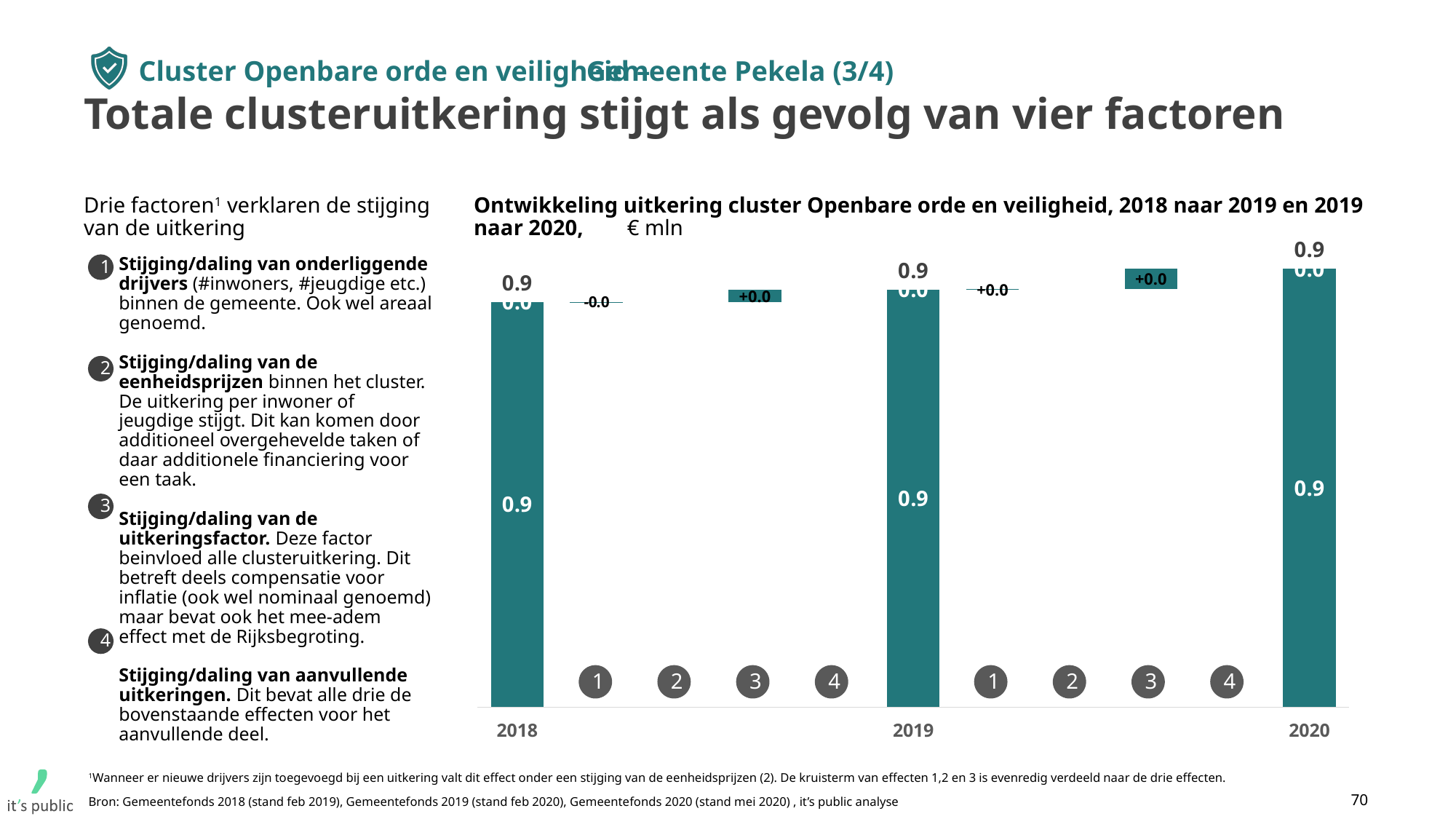
What is the labelled effect of factor 3 between 2018 and 2019? +0.0 What kind of chart is shown on the slide? Bar chart What is the labelled effect of factor 3 between 2019 and 2020? +0.0 What is the total value of the bar for 2018? 0.9 What is the labelled effect of factor 1 between 2018 and 2019? -0.0 What is the total value of the bar for 2020? 0.9 In what unit are the values on the chart expressed? € mln How many years are shown as full bars on the chart? 3 What is the labelled effect of factor 1 between 2019 and 2020? +0.0 What is the total value of the bar for 2019? 0.9 Does the total cluster payment rise, fall or stay the same from 2018 to 2020? Rises How many numbered factors are shown between each pair of years on the chart? 4